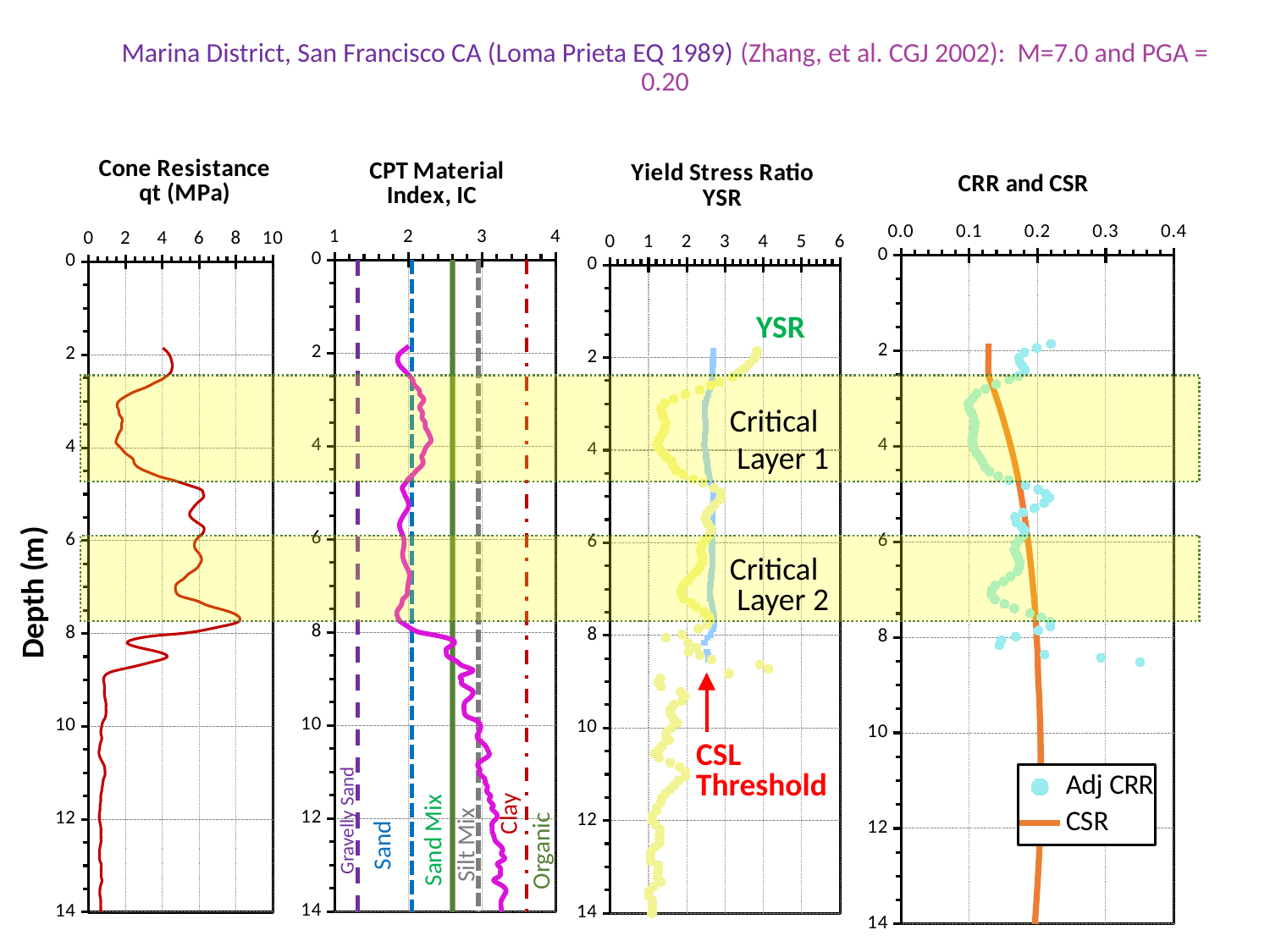
How many charts are shown on the slide? 4 In the CRR and CSR chart, is the CSR value at a depth of 10 m greater or less than 0.3? less In the Cone Resistance qt (MPa) chart, is the cone resistance at a depth of 12 m greater or less than 2? less In the CPT Material Index, IC chart, is the IC value at a depth of 4 m greater or less than 3? less In the CRR and CSR chart, what are the two legend entries? Adj CRR and CSR In the CRR and CSR chart, does the CSR line increase or decrease from a depth of 2 m to a depth of 8 m? increase In the CRR and CSR chart, how many series does the legend list? 2 What kind of chart is the Cone Resistance qt (MPa) chart? line chart Which chart contains the annotation "CSL Threshold"? Yield Stress Ratio YSR